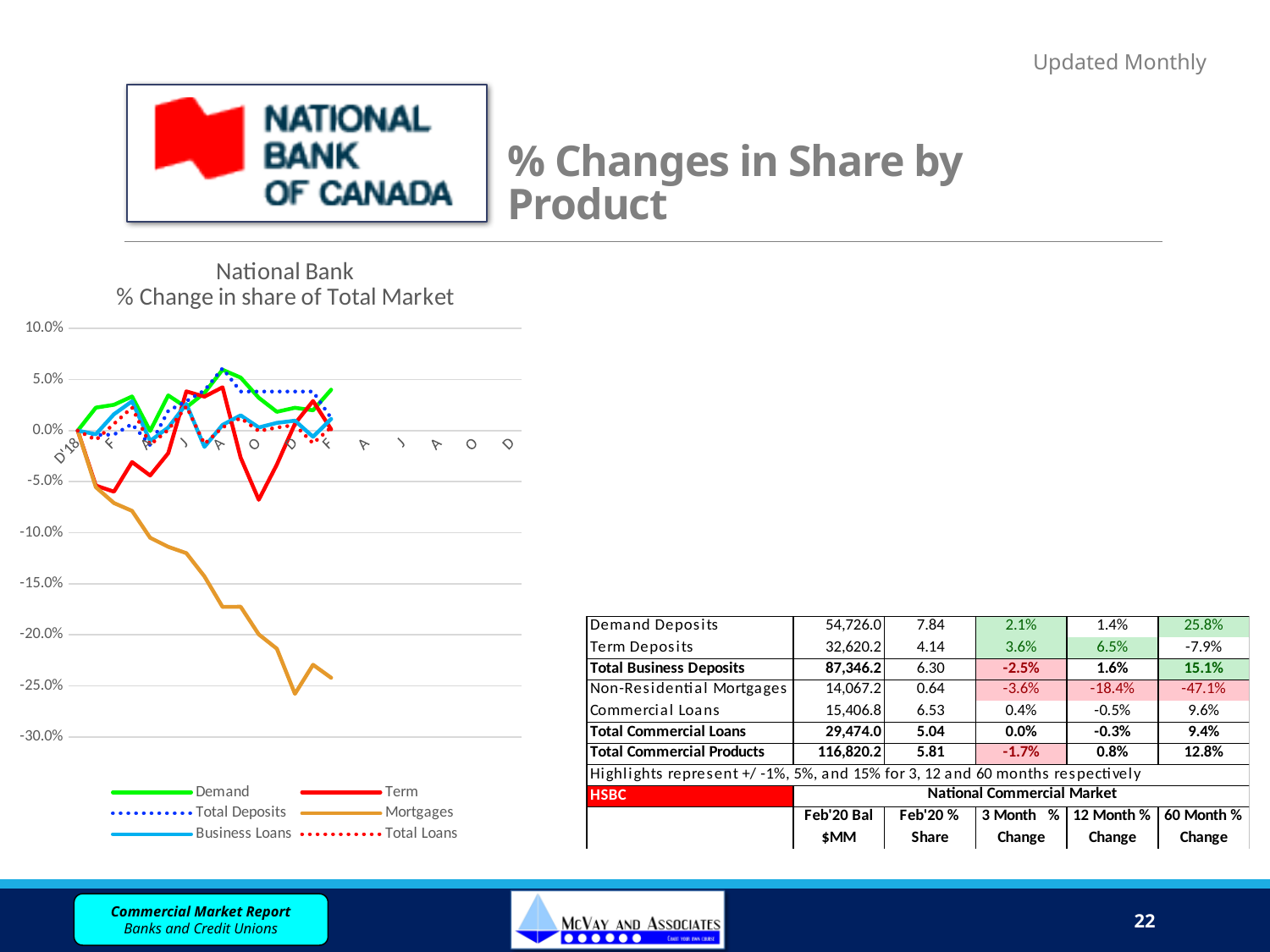
Is the final value of the Mortgages series greater or less than -20.0%? less What is the title of the chart? National Bank % Change in share of Total Market Which series in the chart falls the most over time, ending far below all the others? Mortgages Is the highest point of the Demand series greater or less than 5.0%? greater How many labels are shown along the chart's x axis? 13 What is the first label on the chart's x axis? D'18 What is the lowest value shown on the chart's y axis? -30.0% What kind of chart is shown on the slide? Line chart At the last plotted point, which series is higher: Demand or Mortgages? Demand How many series does the chart's legend list? 6 Is the lowest point of the Term series greater or less than -5.0%? less Does the Mortgages series rise or fall along the x axis? Fall